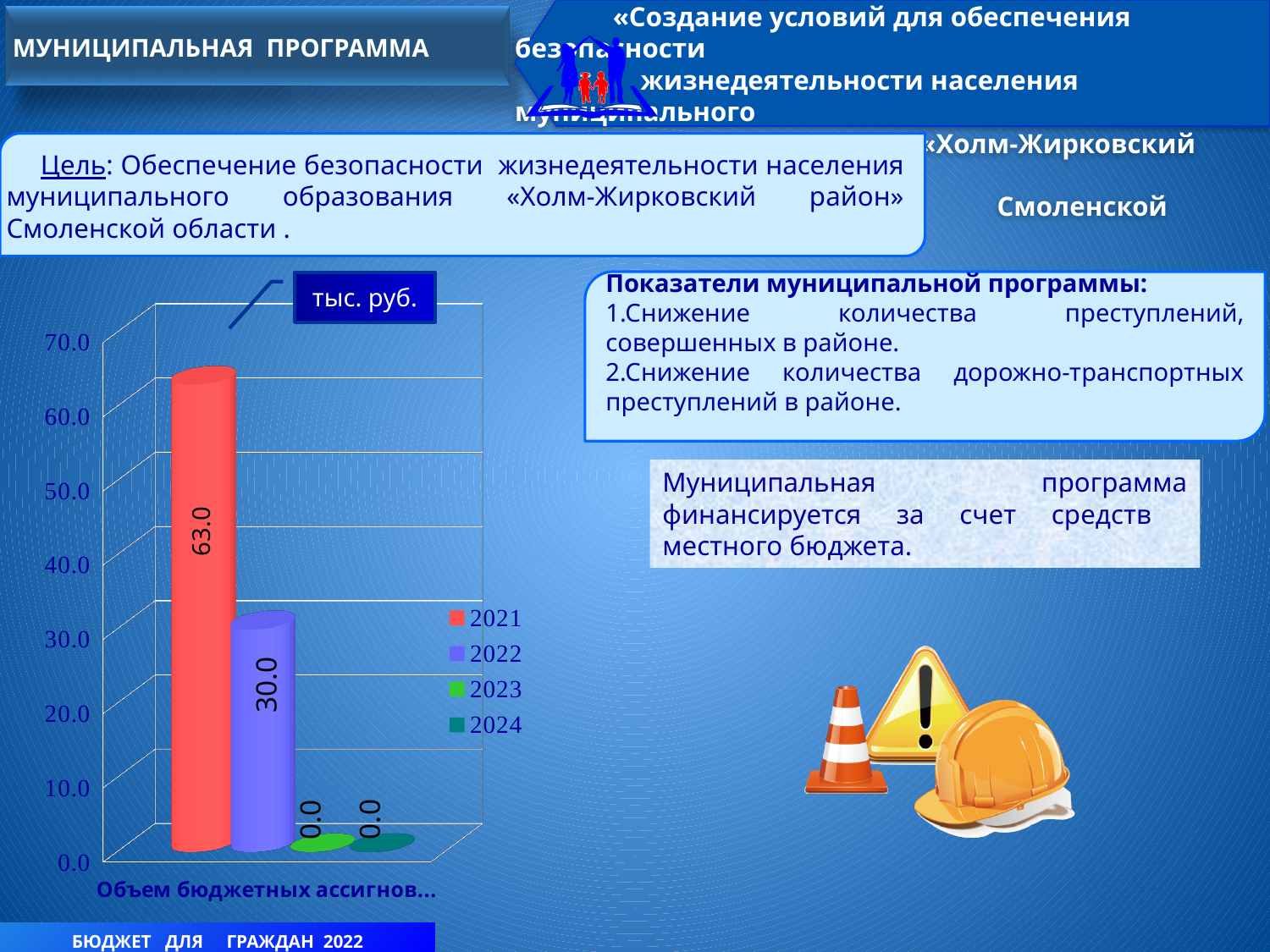
Which year has the highest value in the chart? 2021 Is the value for 2022 greater or less than 40.0? less What kind of chart is shown on the slide? bar chart What is the value for 2022 in the chart? 30.0 Which is larger, the value for 2021 or the value for 2022? 2021 How many series does the chart legend list? 4 What is the value for 2023 in the chart? 0.0 What unit is shown in the label above the chart? тыс. руб. What is the difference between the values for 2021 and 2022? 33.0 What is the value for 2021 in the chart? 63.0 Is the value for 2021 greater or less than 60.0? greater What is the value for 2024 in the chart? 0.0